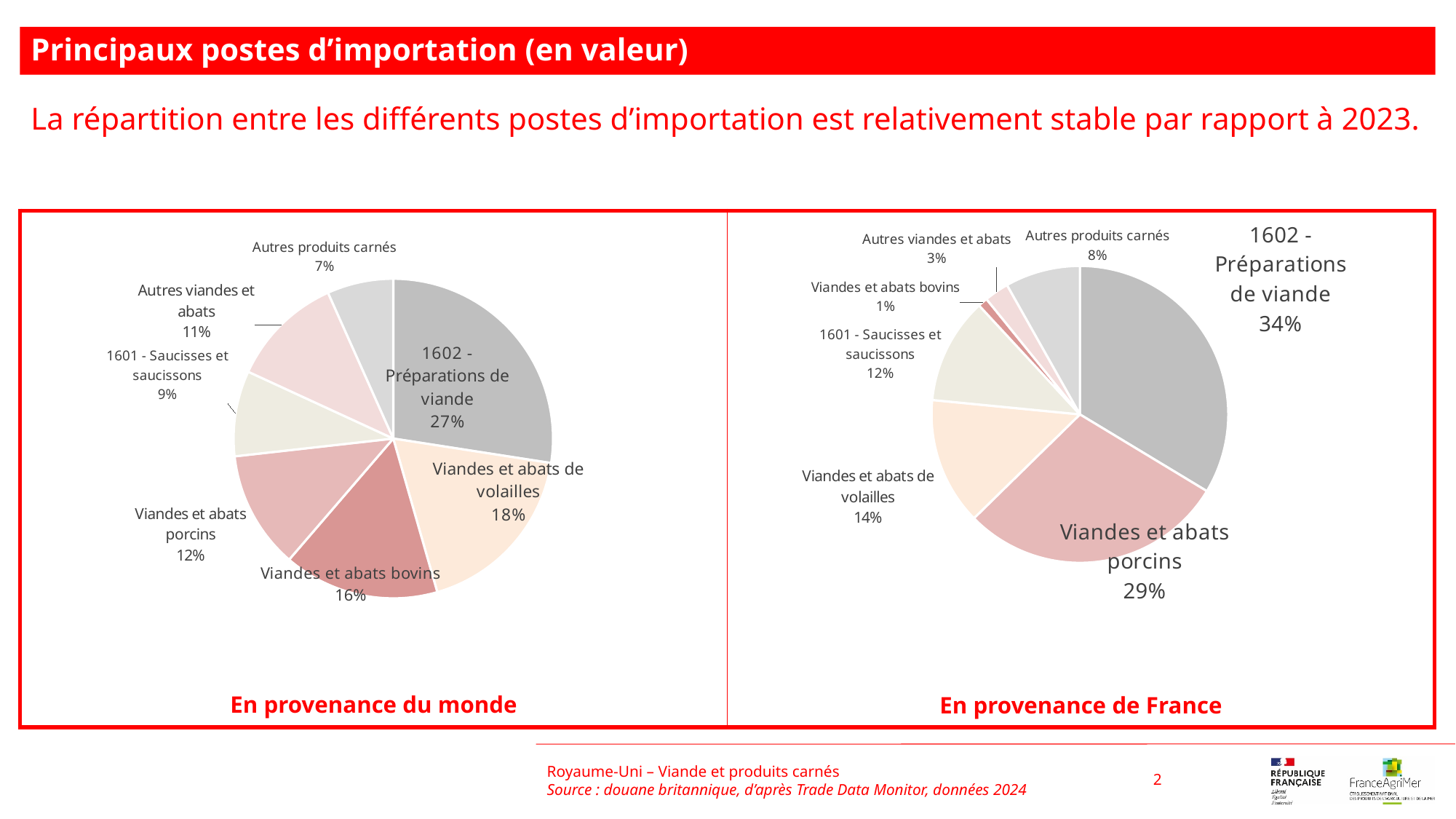
What type of chart is used for 'En provenance du monde'? Pie chart In the 'En provenance du monde' chart, what share do 1602 - Préparations de viande represent? 27% How many categories are shown in the 'En provenance de France' pie chart? 7 In the 'En provenance du monde' chart, which category has the largest share? 1602 - Préparations de viande What is the title of the chart on the right side of the slide? En provenance de France In the 'En provenance du monde' chart, what is the share of Viandes et abats bovins? 16% In the 'En provenance de France' chart, what is the share of Viandes et abats bovins? 1% In the 'En provenance de France' chart, what is the share of Viandes et abats porcins? 29% In the 'En provenance du monde' chart, which category has the smallest share? Autres produits carnés In the 'En provenance du monde' chart, what is the difference in percentage points between Viandes et abats de volailles and Viandes et abats porcins? 6 In the 'En provenance de France' chart, which category has the largest share? 1602 - Préparations de viande In the 'En provenance de France' chart, which is larger: Viandes et abats de volailles or 1601 - Saucisses et saucissons? Viandes et abats de volailles